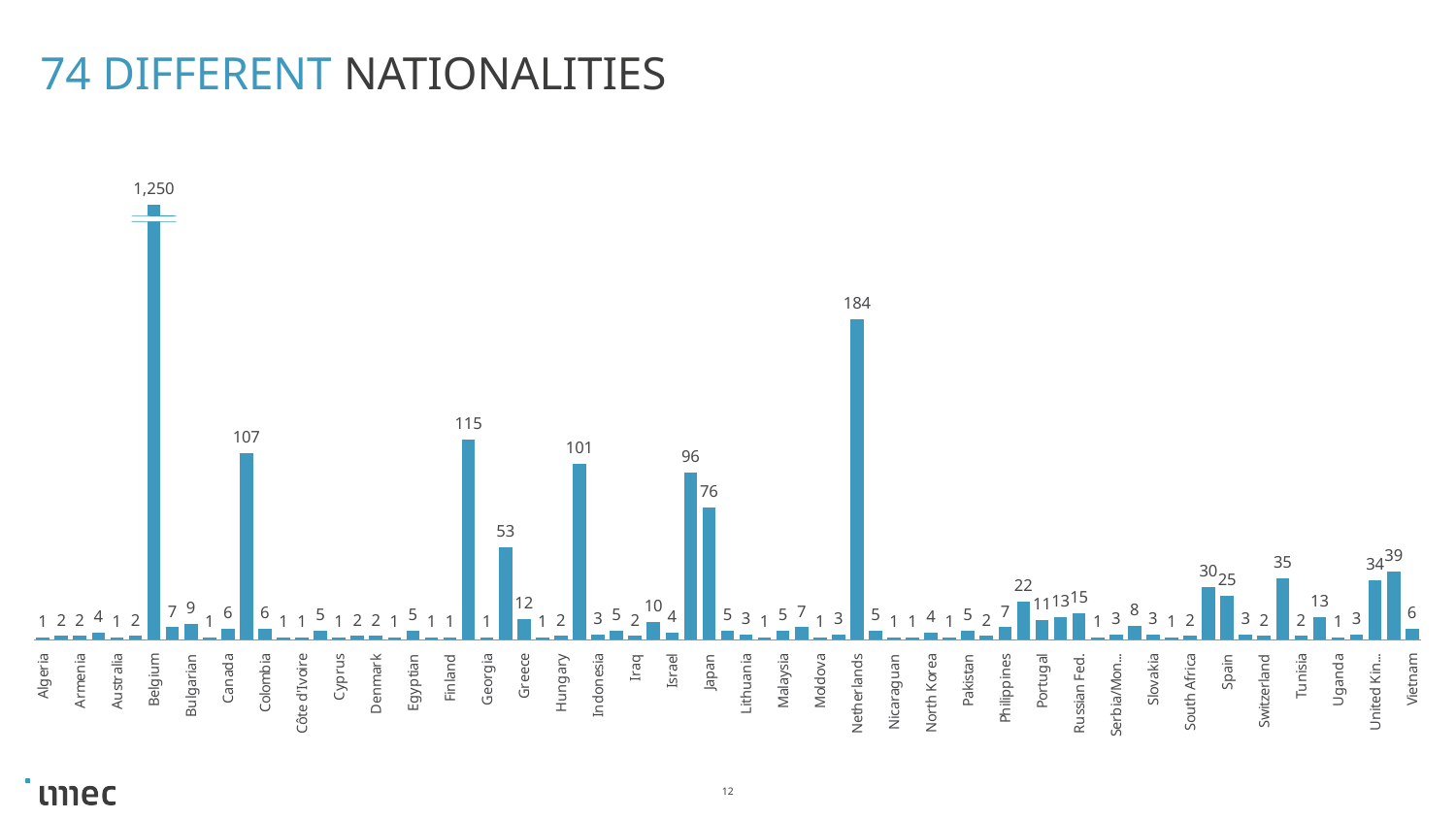
What is the title of the slide? 74 DIFFERENT NATIONALITIES What is the difference between the values for Netherlands and Japan? 108 Which nationality has the highest value in the chart? Belgium What is the value for Russian Fed.? 15 What is the value for Belgium? 1,250 Which is larger, the value for Netherlands or the value for Japan? Netherlands What kind of chart is shown on the slide? bar chart What is the value for Spain? 25 What is the value for Netherlands? 184 What is the value for Japan? 76 What is the value for Vietnam? 6 What is the value for Portugal? 11